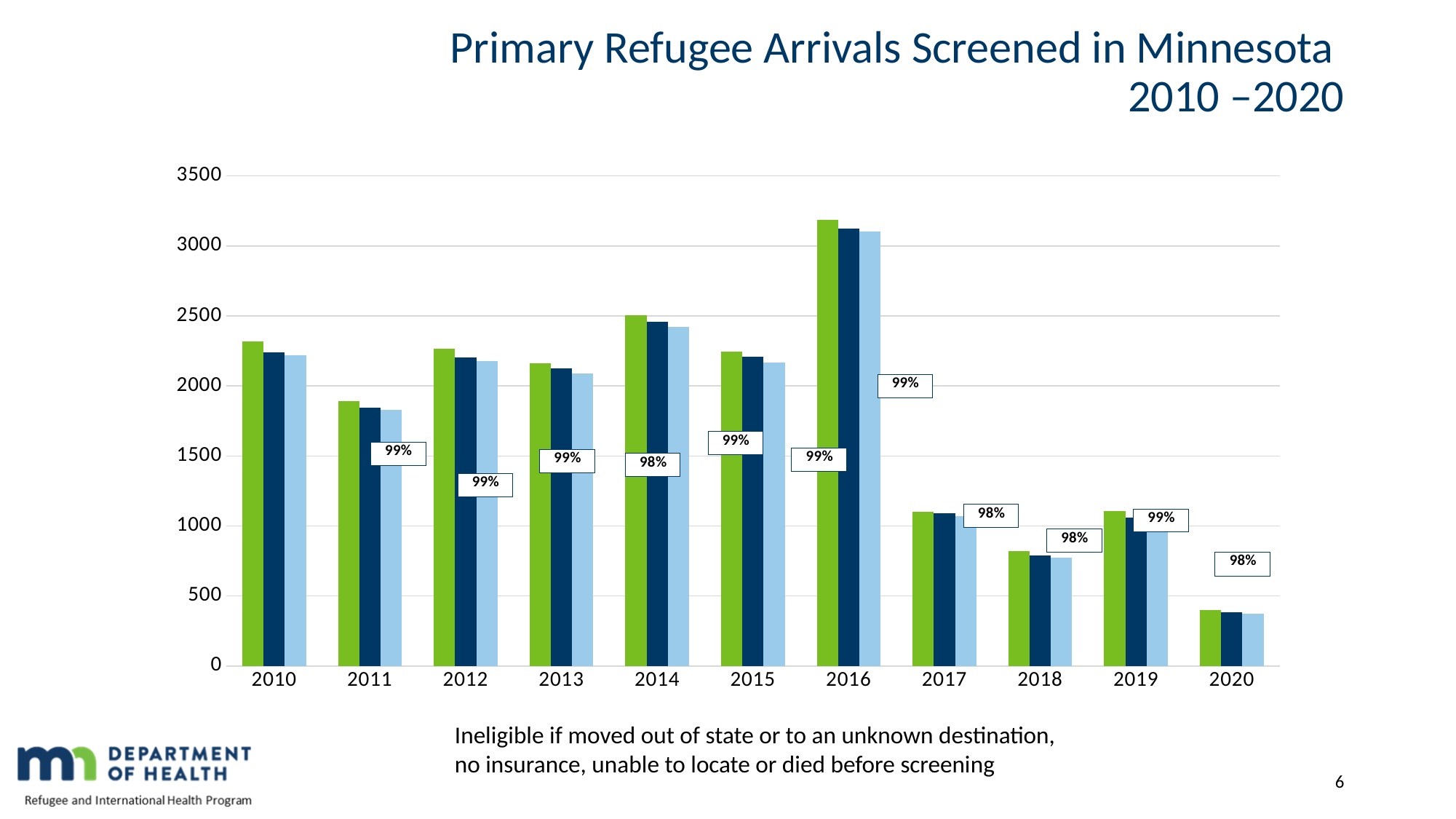
How many bars are plotted for each year in the chart? 3 What percentage label is shown for 2014? 98% Which year has taller bars, 2013 or 2014? 2014 Is the value of the green bar for 2016 greater or less than 3000? greater Which year has the lowest bars in the chart? 2020 Is the value of the green bar for 2020 greater or less than 500? less Which year has the highest bars in the chart? 2016 What kind of chart is shown on the slide? bar chart Is the value of the green bar for 2018 greater or less than 1000? less How many years are shown on the x axis of the chart? 11 What percentage label is shown for 2016? 99%